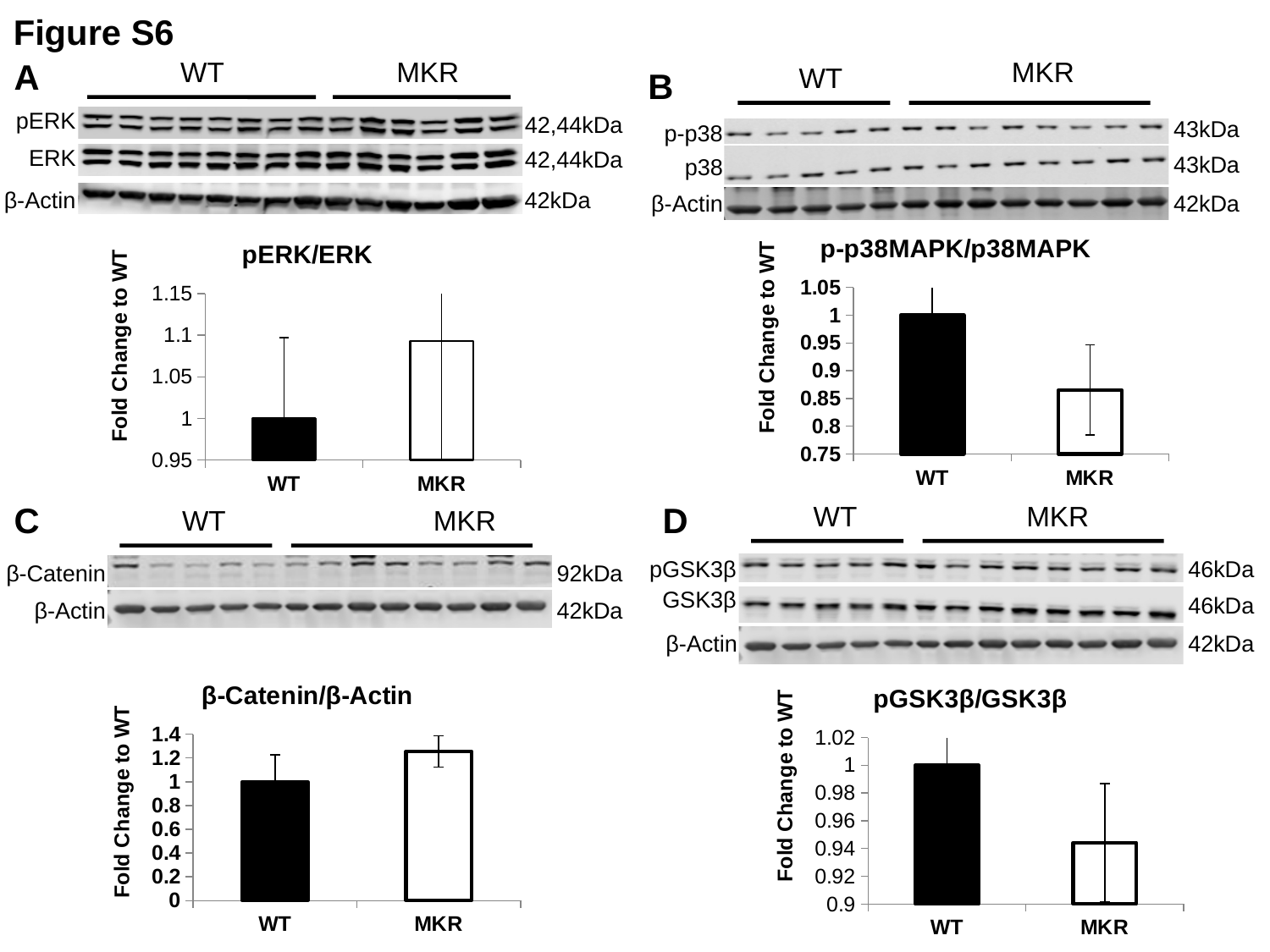
In the pGSK3β/GSK3β chart, is the value for MKR greater or less than 0.96? less In the β-Catenin/β-Actin chart, is the value for MKR greater or less than 1.2? greater In the β-Catenin/β-Actin chart, which category has the highest bar? MKR What kind of chart is the β-Catenin/β-Actin chart? bar chart In the pGSK3β/GSK3β chart, what is the value for WT? 1 In the p-p38MAPK/p38MAPK chart, what is the value for WT? 1 In the pERK/ERK chart, what is the value for WT? 1 How many categories are shown on the x axis of the pGSK3β/GSK3β chart? 2 In the p-p38MAPK/p38MAPK chart, is the value for MKR greater or less than 0.9? less In the p-p38MAPK/p38MAPK chart, which category has the lowest bar? MKR In the pERK/ERK chart, which category has the higher bar, WT or MKR? MKR